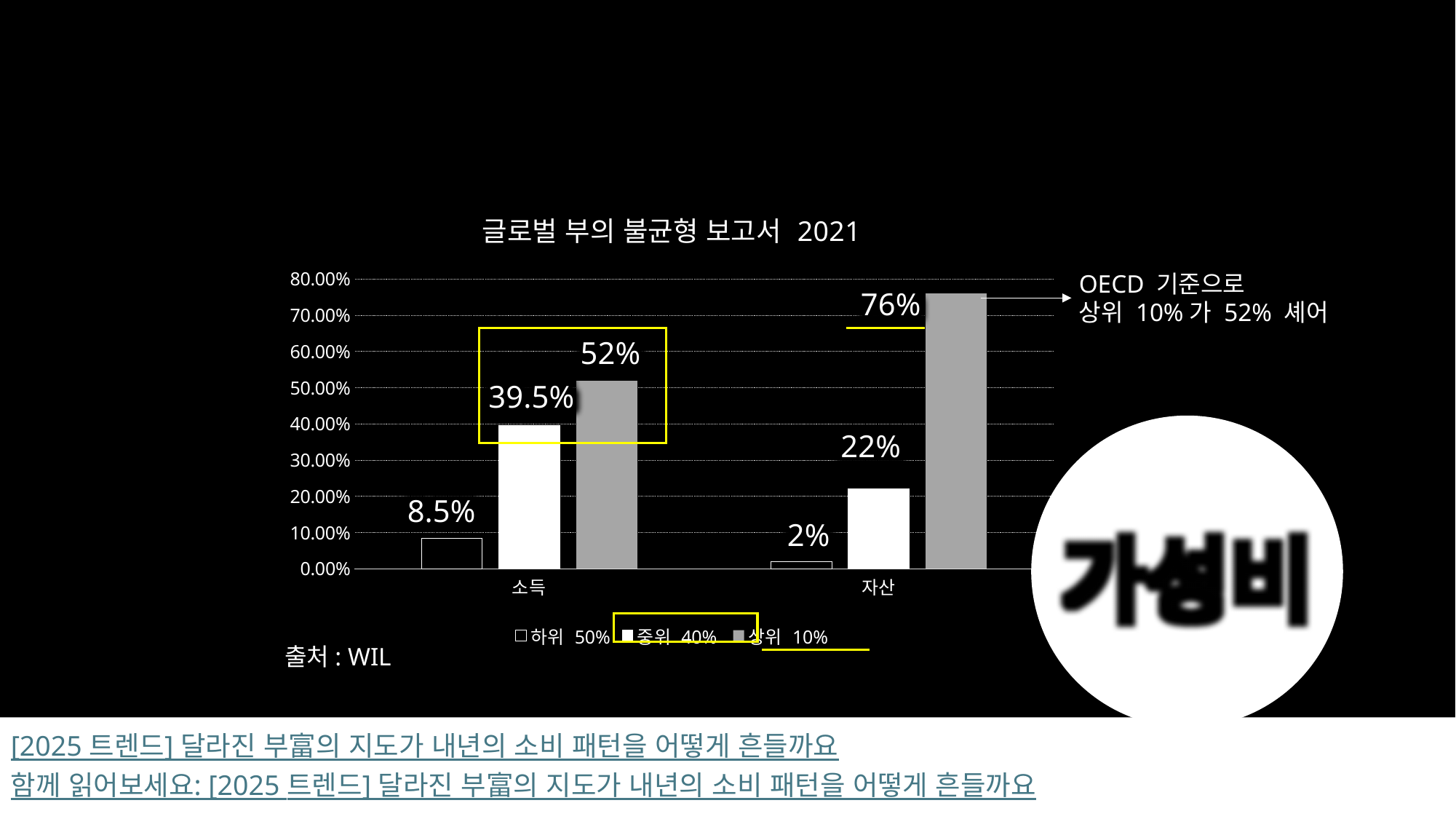
What is the value for 상위 10% in the 자산 category? 76% Which is larger: the 중위 40% value for 소득 or for 자산? 소득 What is the value for 상위 10% in the 소득 category? 52% What is the value for 중위 40% in the 소득 category? 39.5% What kind of chart is shown on the slide? bar chart How many categories are shown on the x axis? 2 How many series does the legend list? 3 What is the value for 하위 50% in the 자산 category? 2% Which series has the highest value in the 자산 category? 상위 10% Which series has the lowest value in the 소득 category? 하위 50% What is the title of the chart? 글로벌 부의 불균형 보고서 2021 What is the difference between the 상위 10% values for 자산 and 소득? 24%